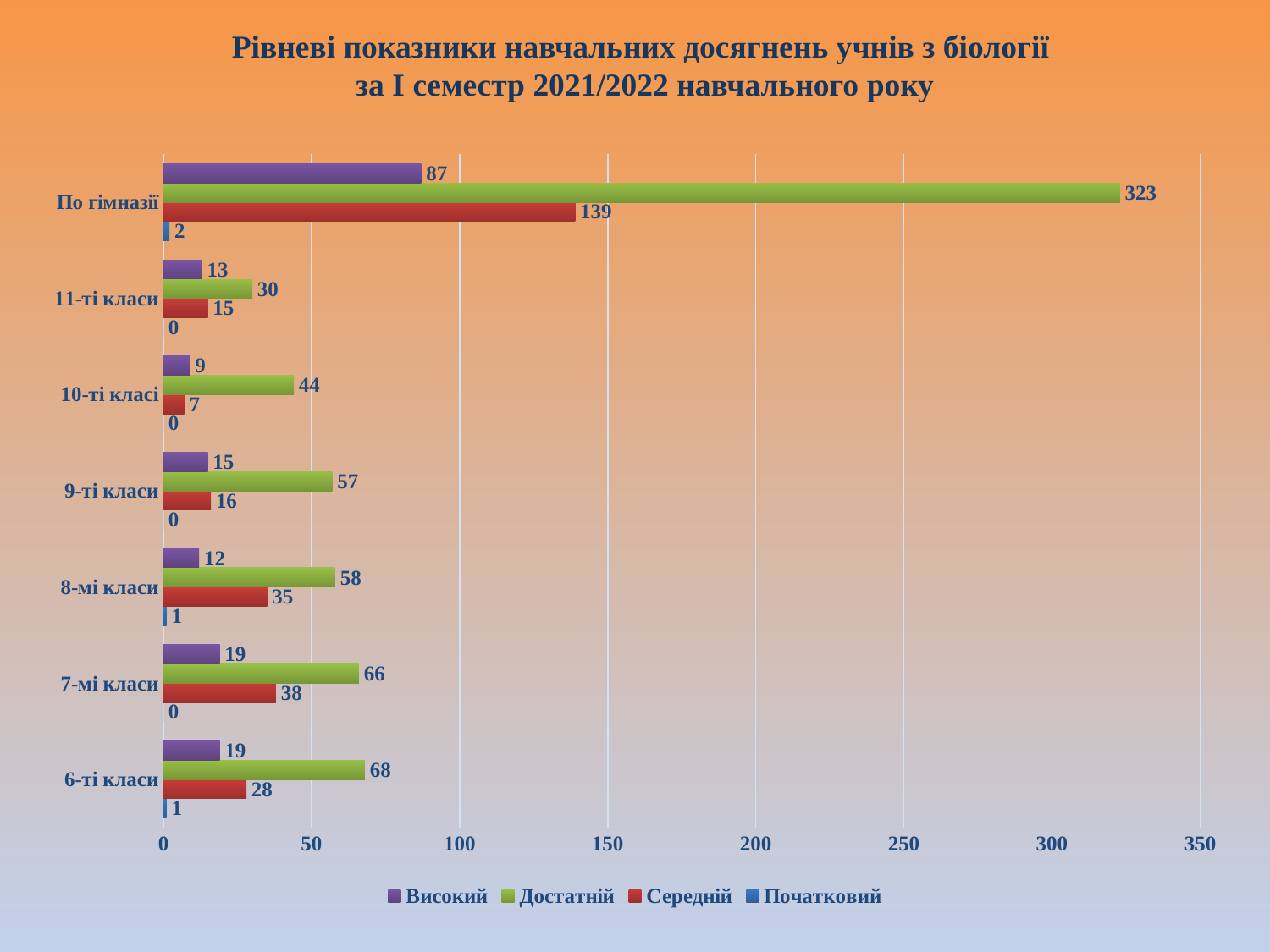
What is the value of Високий for 10-ті класі? 9 Among the class groups (excluding По гімназії), which category has the lowest Середній value? 10-ті класі Among the class groups (excluding По гімназії), which category has the highest Достатній value? 6-ті класи What kind of chart is shown on the slide? Bar chart What is the value of Середній for 7-мі класи? 38 Which is larger: the Високий value for 11-ті класи or the Високий value for 9-ті класи? 9-ті класи What is the value of Початковий for 8-мі класи? 1 How many categories are shown on the vertical axis? 7 What is the difference between the Достатній and Середній values for По гімназії? 184 What is the value of Достатній for По гімназії? 323 Which series is shown in green in the legend? Достатній How many series does the legend list? 4